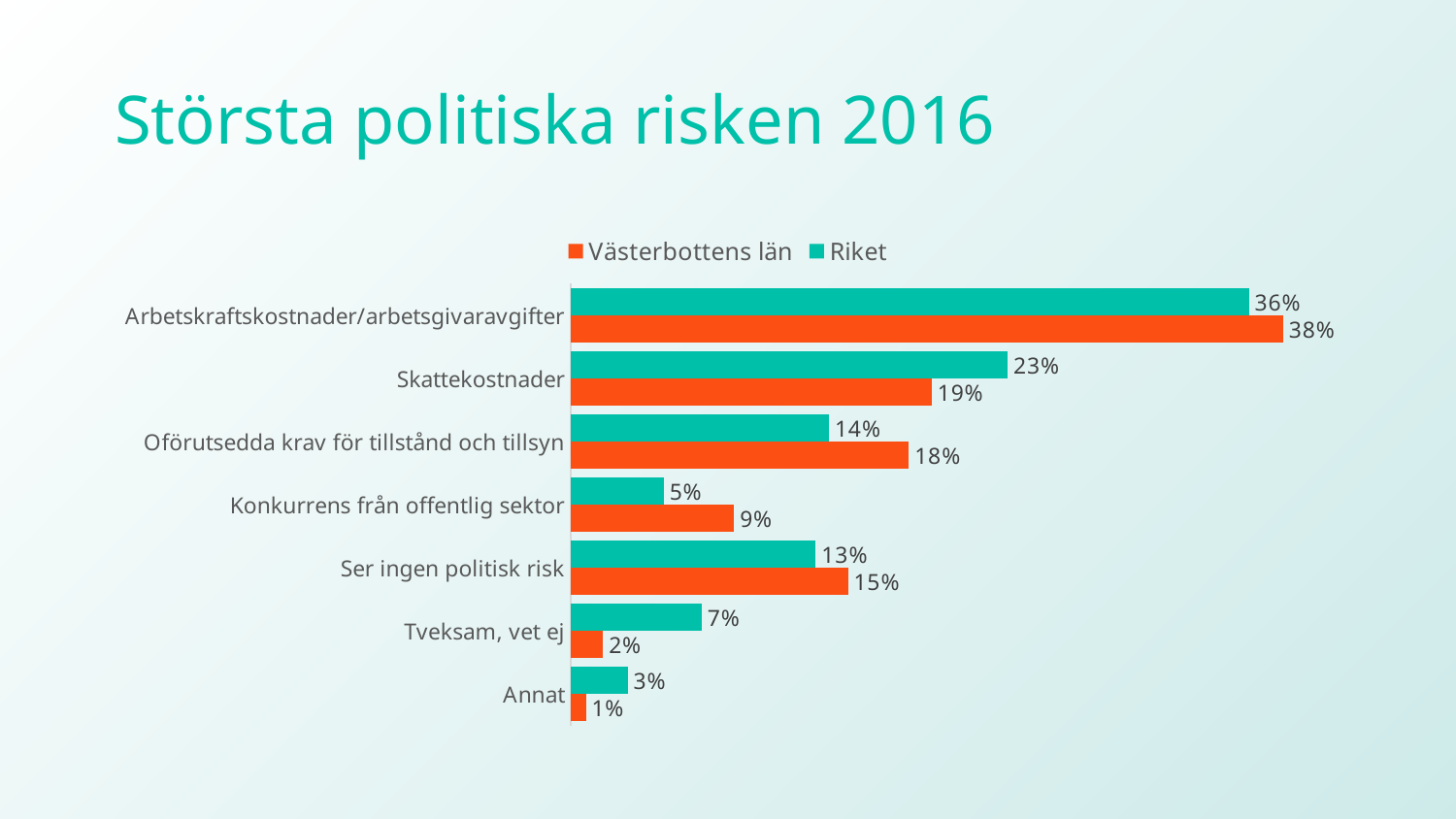
How many series does the legend list? 2 What is the difference between Västerbottens län and Riket for Oförutsedda krav för tillstånd och tillsyn? 4 percentage points Which category has the lowest value for Västerbottens län? Annat What is the value for Riket for Tveksam, vet ej? 7% Which is larger for Skattekostnader: Västerbottens län or Riket? Riket What is the title of the slide? Största politiska risken 2016 What kind of chart is shown on the slide? Bar chart Which category has the highest value for Riket? Arbetskraftskostnader/arbetsgivaravgifter What is the value for Västerbottens län for Arbetskraftskostnader/arbetsgivaravgifter? 38% What is the value for Riket for Skattekostnader? 23% What is the value for Västerbottens län for Konkurrens från offentlig sektor? 9% How many categories are shown in the chart? 7